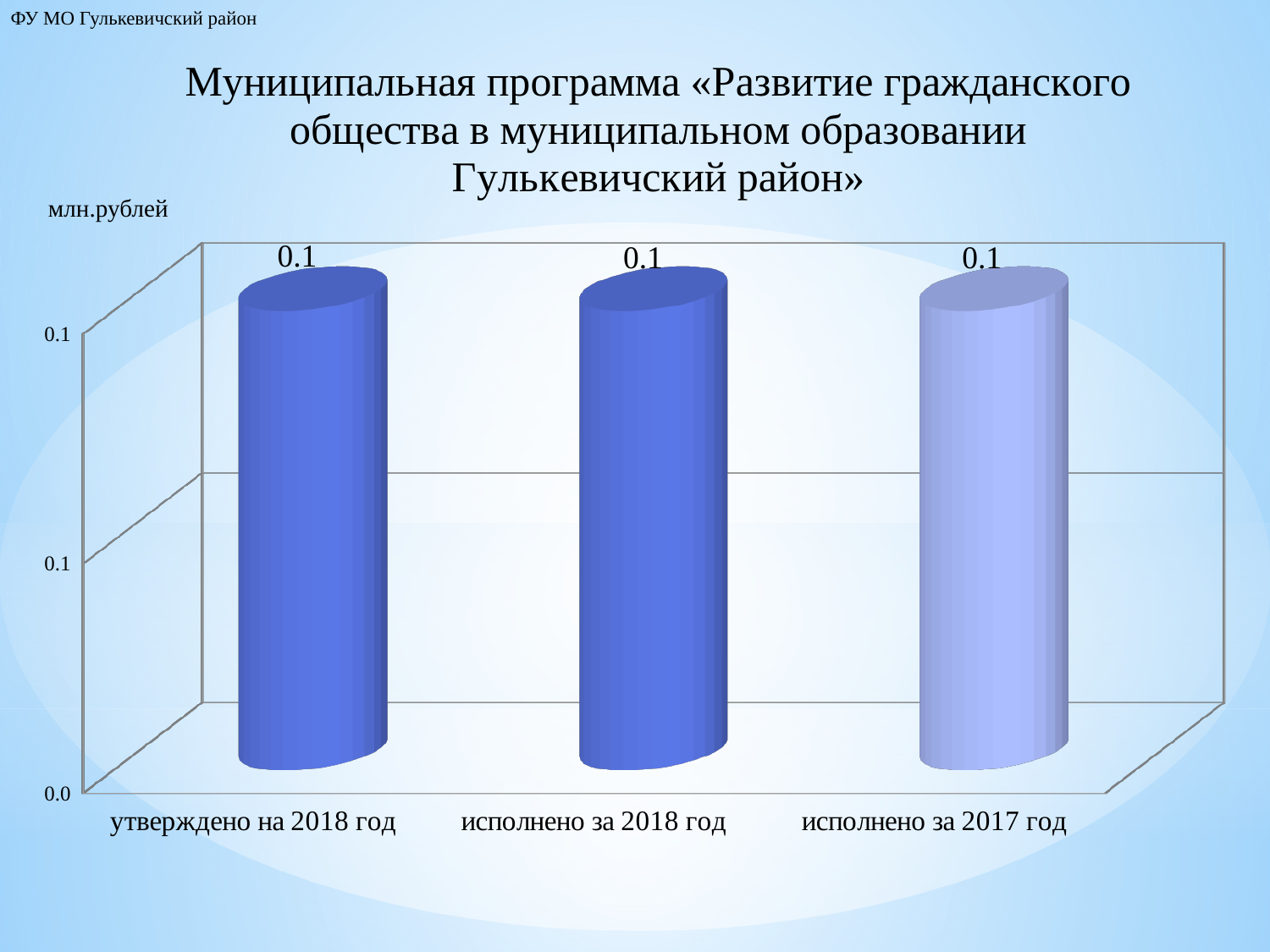
How many categories are shown on the chart? 3 What is the value for «исполнено за 2017 год»? 0.1 What unit of measurement is indicated above the chart? млн.рублей What is the value for «утверждено на 2018 год»? 0.1 Is the value for «исполнено за 2017 год» greater or less than 0.0? greater What is the difference between the values for «утверждено на 2018 год» and «исполнено за 2018 год»? 0.0 Do the values rise, fall, or stay the same across the categories from left to right? stay the same What kind of chart is shown on the slide? bar chart What is the label of the rightmost category on the x axis? исполнено за 2017 год What is the value for «исполнено за 2018 год»? 0.1